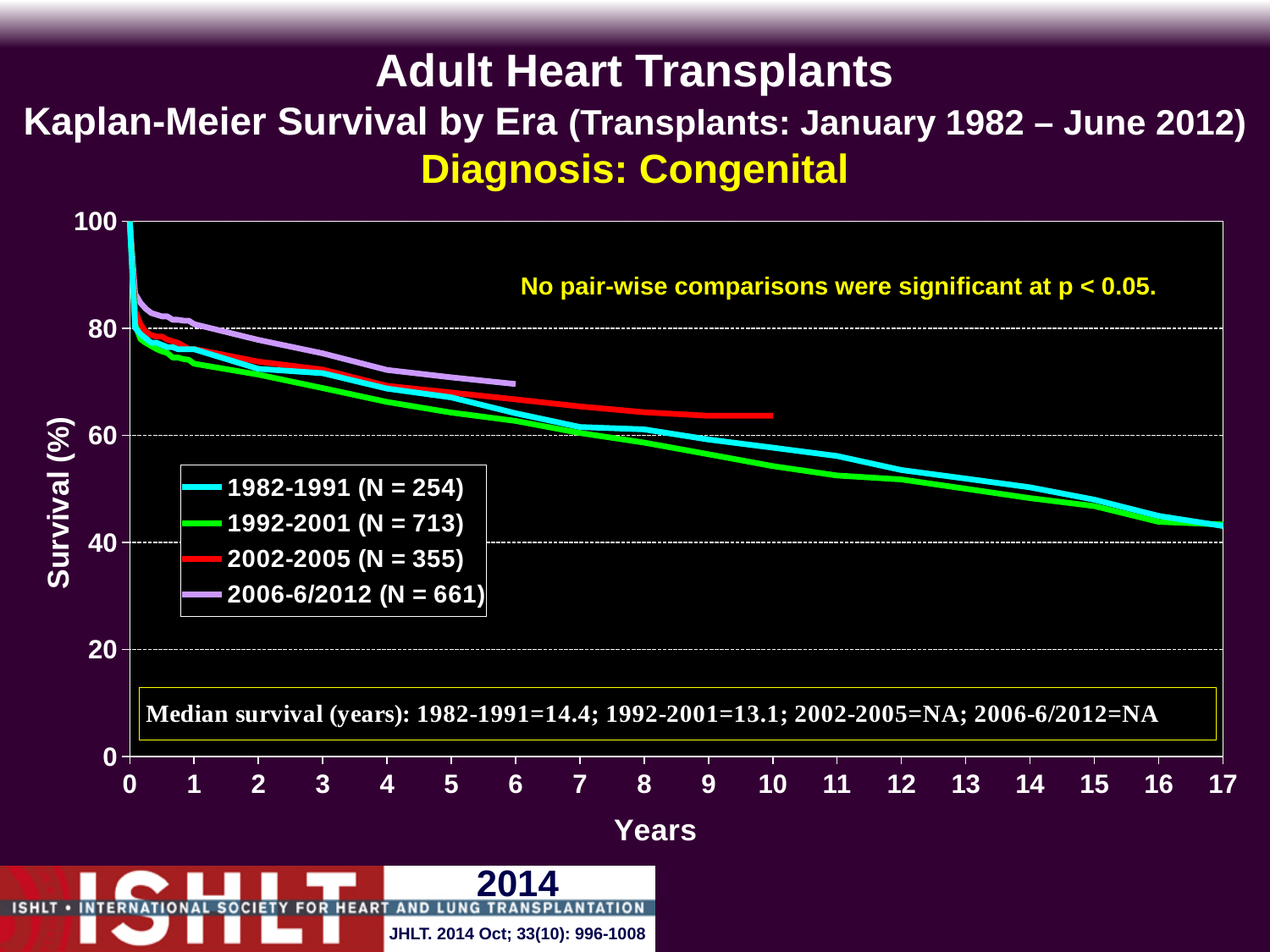
At 3 years, which era has higher survival: 2006-6/2012 or 1992-2001? 2006-6/2012 Is the survival for the 1992-2001 era at 1 year greater or less than 80%? less How many transplants (N) are in the 2002-2005 era? 355 Is the survival for the 2006-6/2012 era at 5 years greater or less than 60%? greater What is the difference in median survival (years) between the 1982-1991 and 1992-2001 eras? 1.3 What is the median survival in years for the 1982-1991 era? 14.4 Do the survival curves rise or fall as years increase? fall How many eras (series) does the legend list? 4 What is the median survival in years for the 1992-2001 era? 13.1 What is the median survival listed for the 2006-6/2012 era? NA Which era has the highest survival at 5 years? 2006-6/2012 What kind of chart is shown on the slide? line chart